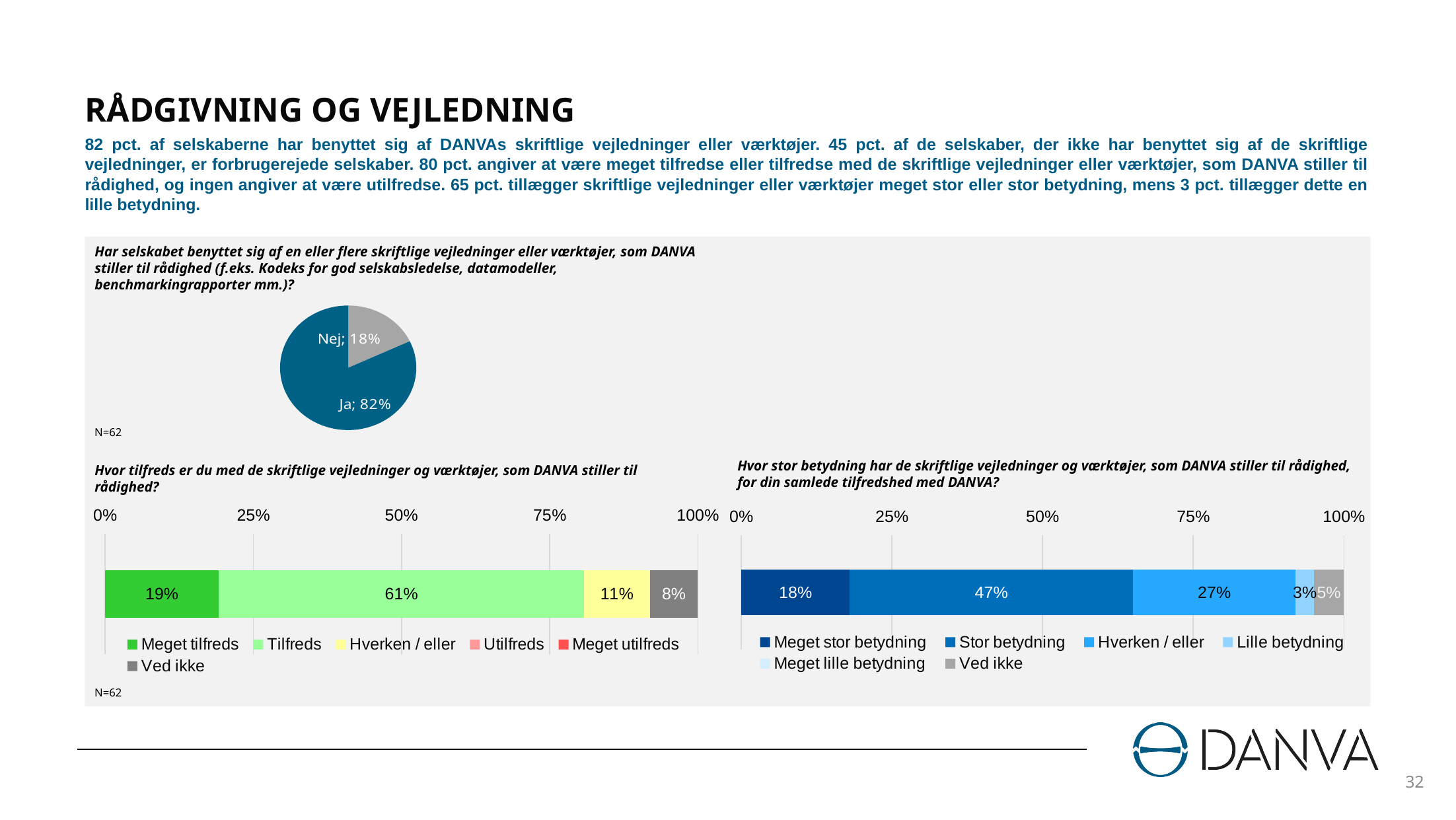
In the bottom-right chart ("Hvor stor betydning har de skriftlige vejledninger..."), what is the value for "Stor betydning"? 47% In the bottom-left chart ("Hvor tilfreds er du med de skriftlige vejledninger og værktøjer..."), what is the value for "Meget tilfreds"? 19% In the bottom-left chart ("Hvor tilfreds er du med de skriftlige vejledninger og værktøjer..."), what is the value for "Tilfreds"? 61% In the pie chart at the top of the slide, what share of companies answered "Ja"? 82% In the pie chart at the top of the slide, what share of companies answered "Nej"? 18% What kind of chart is the bottom-right chart ("Hvor stor betydning har de skriftlige vejledninger...")? Stacked bar chart How many series does the legend of the bottom-left chart ("Hvor tilfreds er du...") list? 6 In the bottom-left chart ("Hvor tilfreds er du med de skriftlige vejledninger og værktøjer..."), what is the difference between "Tilfreds" and "Meget tilfreds"? 42 percentage points In the bottom-right chart ("Hvor stor betydning har de skriftlige vejledninger..."), which is larger: "Meget stor betydning" or "Hverken / eller"? Hverken / eller In the bottom-left chart ("Hvor tilfreds er du med de skriftlige vejledninger og værktøjer..."), which category has the largest share? Tilfreds In the bottom-right chart ("Hvor stor betydning har de skriftlige vejledninger..."), what is the value for "Hverken / eller"? 27% What kind of chart is the chart at the top of the slide showing Ja and Nej? Pie chart